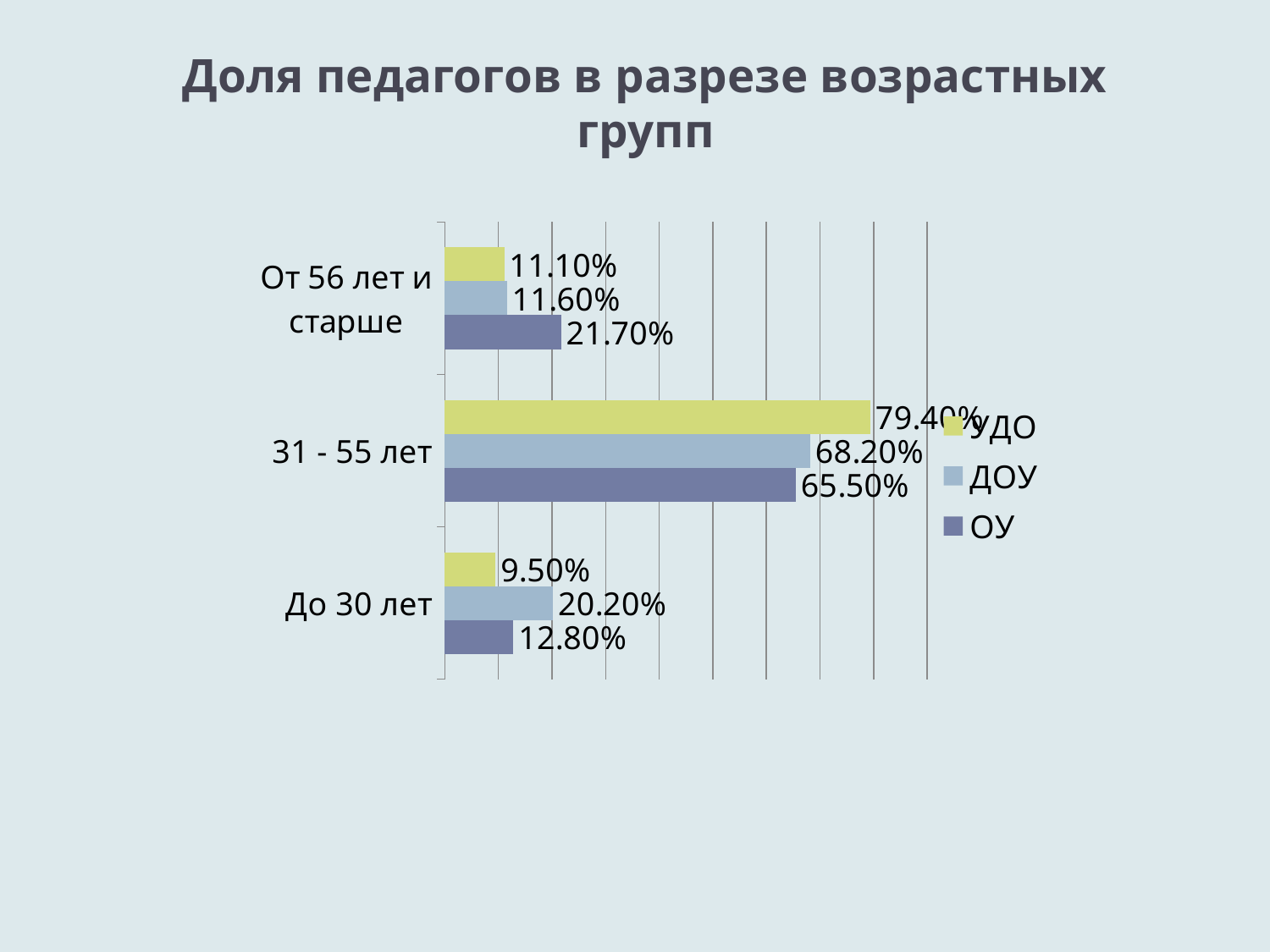
What kind of chart is shown on the slide? Bar chart What is the title of the chart? Доля педагогов в разрезе возрастных групп What is the value for ДОУ in the До 30 лет category? 20.20% In the До 30 лет category, which is larger: the value for ДОУ or the value for ОУ? ДОУ Which age group has the lowest value for ОУ? До 30 лет What is the difference between the УДО and ДОУ values in the 31 - 55 лет category? 11.20% How many age group categories are shown on the chart? 3 How many series does the legend list? 3 What is the difference between the ОУ and ДОУ values in the От 56 лет и старше category? 10.10% Which age group has the highest value for УДО? 31 - 55 лет What is the value for ОУ in the 31 - 55 лет category? 65.50% What is the value for УДО in the От 56 лет и старше category? 11.10%